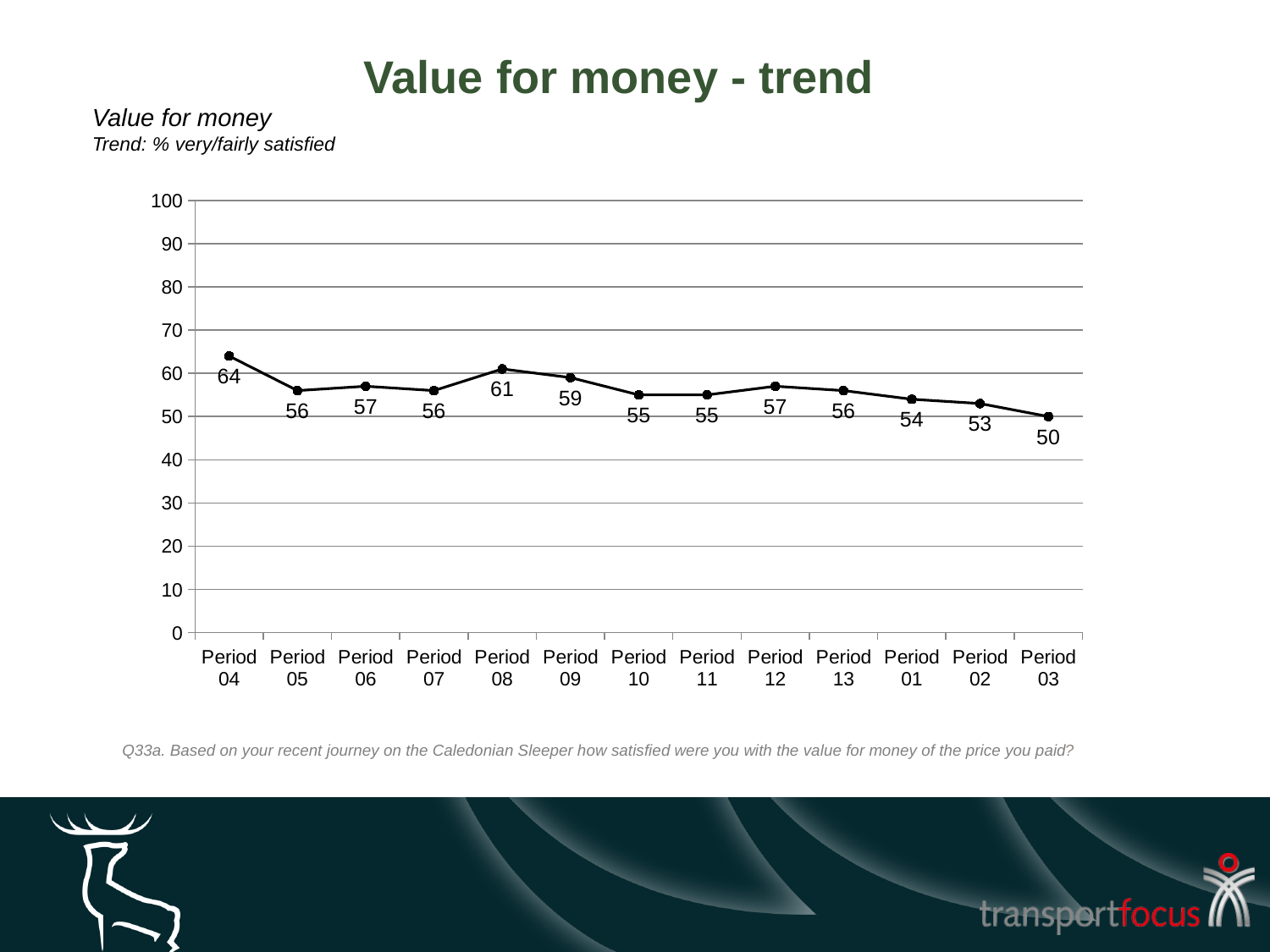
What is the value for Period 03? 50 What is the value for Period 08? 61 Do the values generally rise or fall from Period 04 to Period 03? fall Which is larger, the value for Period 08 or the value for Period 09? Period 08 Is the value for Period 12 greater or less than 50? greater What is the title of the chart? Value for money What is the value for Period 04? 64 What kind of chart is shown on the slide? line chart Which period has the highest value? Period 04 What is the difference between the values for Period 04 and Period 03? 14 Which period has the lowest value? Period 03 How many periods are plotted on the chart? 13